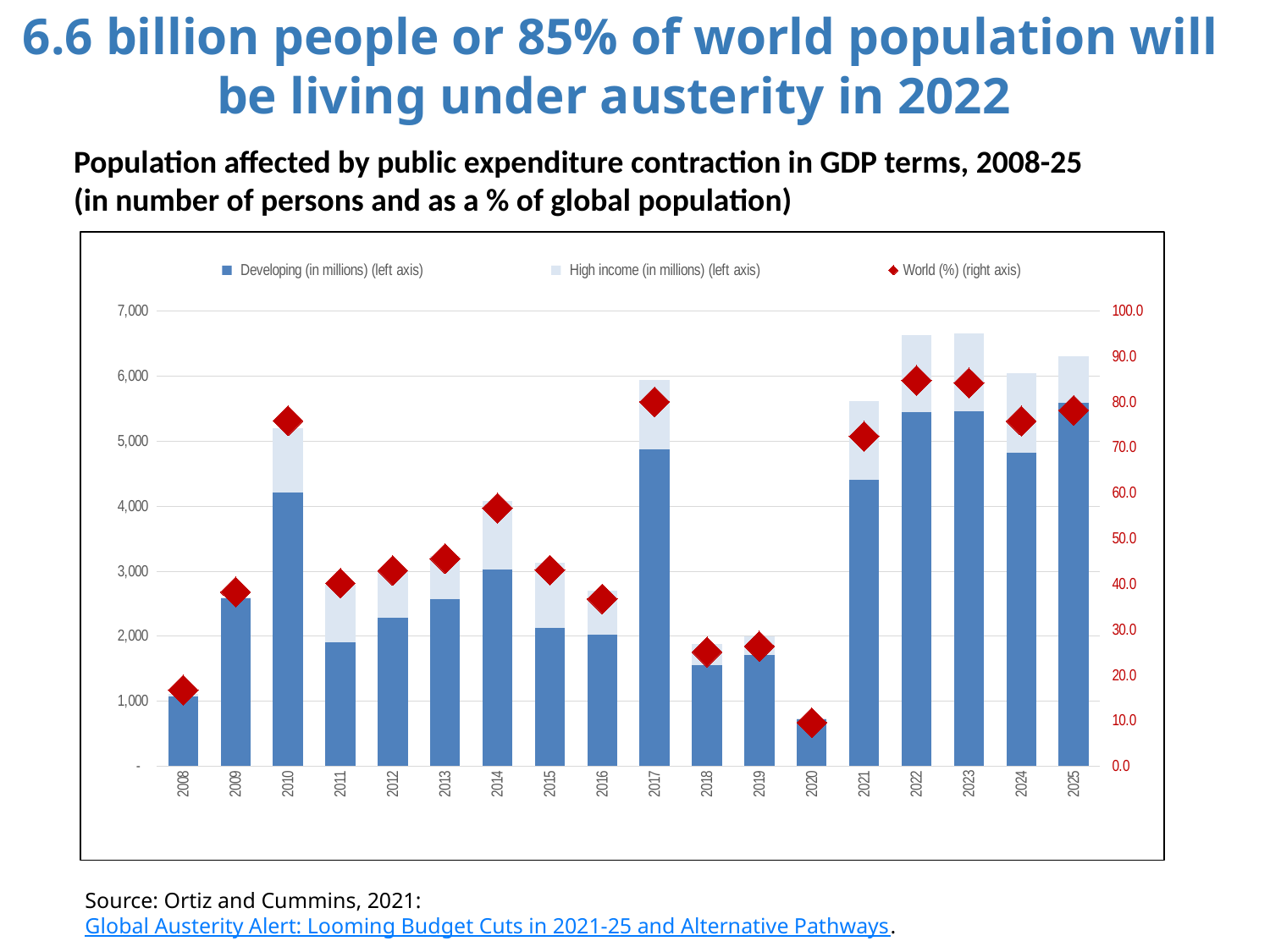
Which year has the lowest total stacked bar? 2020 Is the total stacked bar for 2020 greater or less than 1,000 on the left axis? less Is the World (%) value for 2020 greater or less than 20.0 on the right axis? less How many years are shown along the x axis of the chart? 18 What kind of chart is shown on the slide? combination chart (stacked bars with diamond markers) Is the World (%) value for 2022 greater or less than 80.0 on the right axis? greater Which year has the larger Developing (in millions) bar, 2010 or 2011? 2010 Which series in the legend is plotted on the right axis? World (%) How many series does the chart's legend list? 3 Which year has the larger total stacked bar, 2014 or 2017? 2017 Do the total stacked bars rise or fall from 2017 to 2020? fall